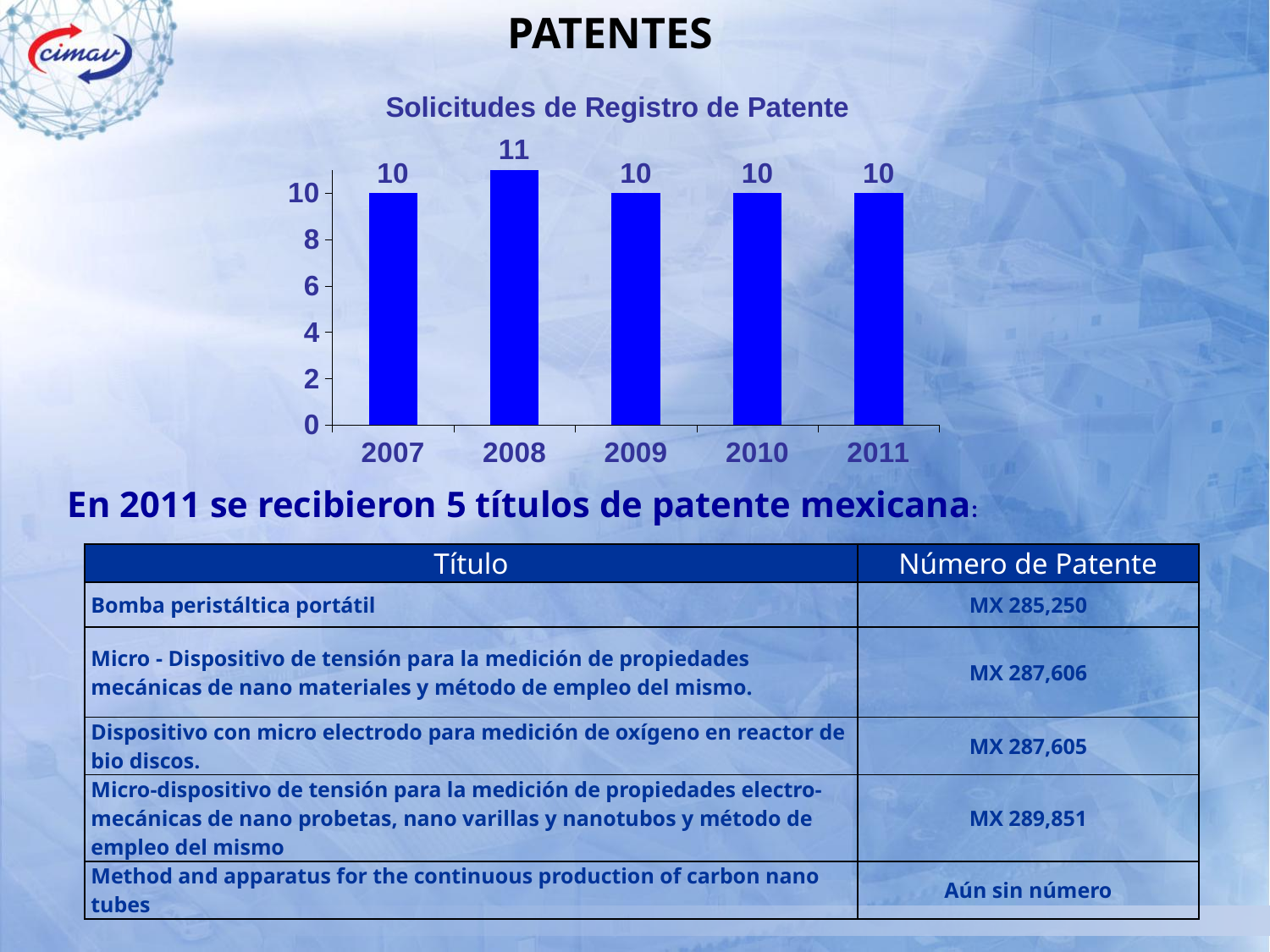
What is the value for 2008 in the chart? 11 What is the total of the values for 2007 and 2008? 21 What is the difference between the values for 2008 and 2009? 1 How many years are shown on the x axis of the chart? 5 What kind of chart is shown on the slide? bar chart What is the value for 2011 in the chart? 10 What is the highest tick value shown on the y axis of the chart? 10 Which is larger, the value for 2008 or the value for 2010? 2008 Is the value for 2008 greater or less than 8? greater What is the title of the chart? Solicitudes de Registro de Patente What is the value for 2007 in the chart? 10 Which year has the highest value in the chart? 2008